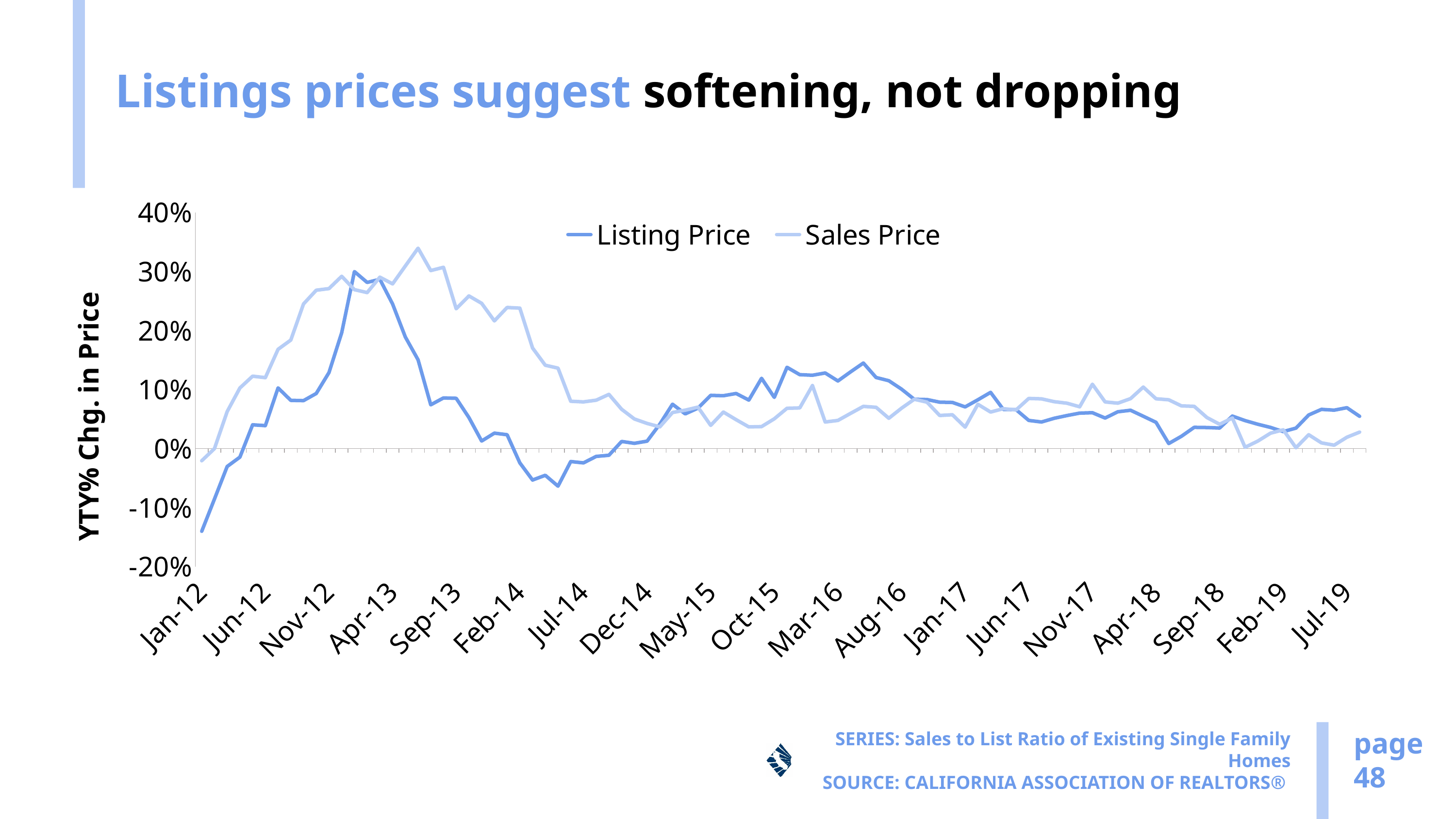
Is the Listing Price value at Jan-12 greater or less than -10%? less At Jan-12, which series has the higher value, Listing Price or Sales Price? Sales Price What is the title of the vertical axis? YTY% Chg. in Price Which series reaches the highest peak on the chart? Sales Price At Mar-16, which series has the higher value, Listing Price or Sales Price? Listing Price Is the Listing Price value at Jul-14 greater or less than 0%? less Does the Listing Price line rise or fall from Jan-12 to Apr-13? Rise How many series does the legend list? 2 What kind of chart is shown on the slide? Line chart What are the two series named in the legend? Listing Price and Sales Price Does the Sales Price line rise or fall from Sep-13 to Jul-14? Fall Is the peak Sales Price value around Sep-13 greater or less than 30%? greater